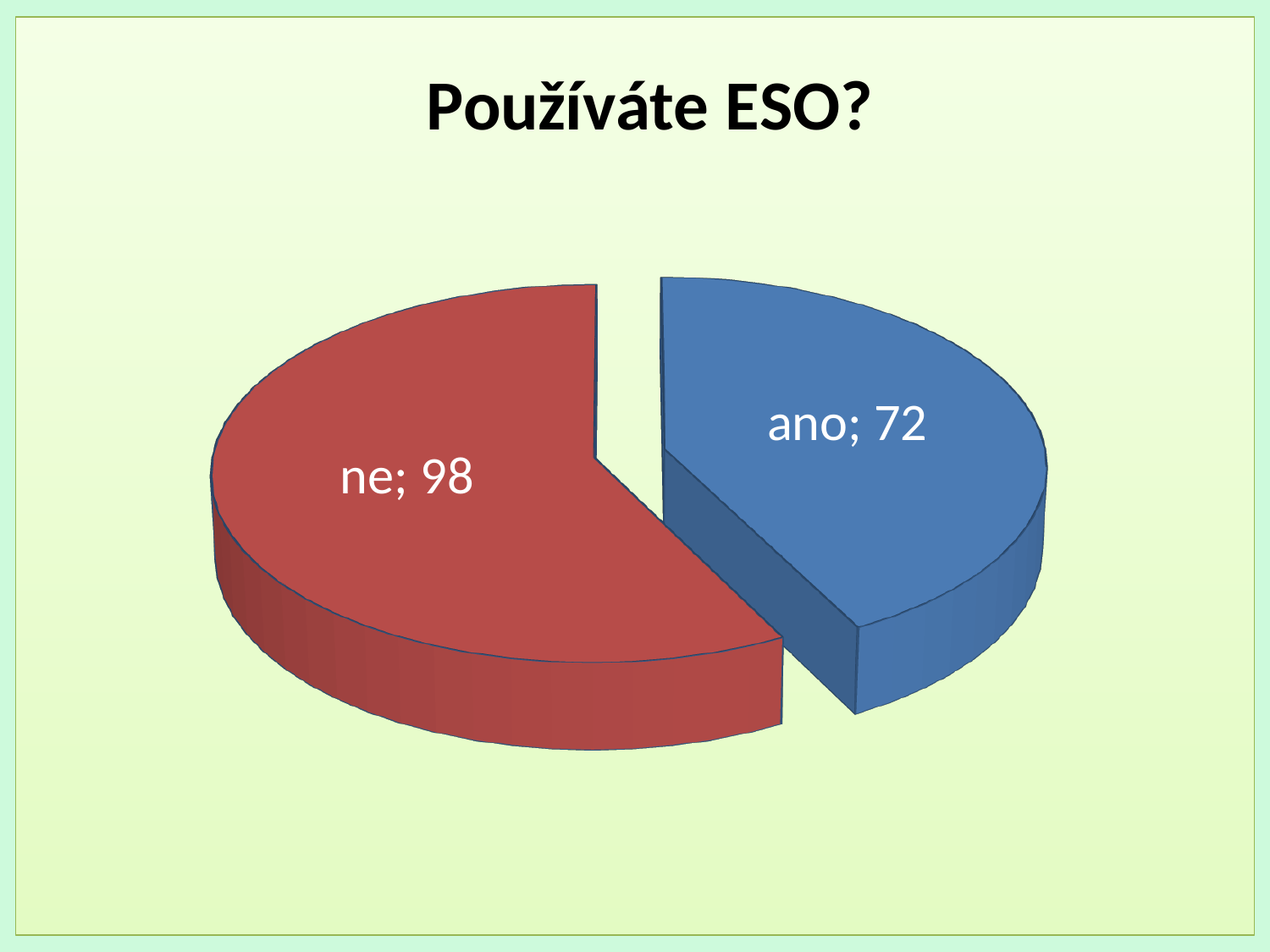
What is the difference between the values for "ne" and "ano"? 26 What is the value for "ne"? 98 What kind of chart is shown on the slide? pie chart How many slices does the pie chart have? 2 Which is larger, the value for "ano" or the value for "ne"? ne Which category has the smallest slice? ano What is the title of the chart? Používáte ESO? What colour is the "ano" slice? blue Which category has the largest slice? ne What is the value for "ano"? 72 What is the total of all slices in the pie chart? 170